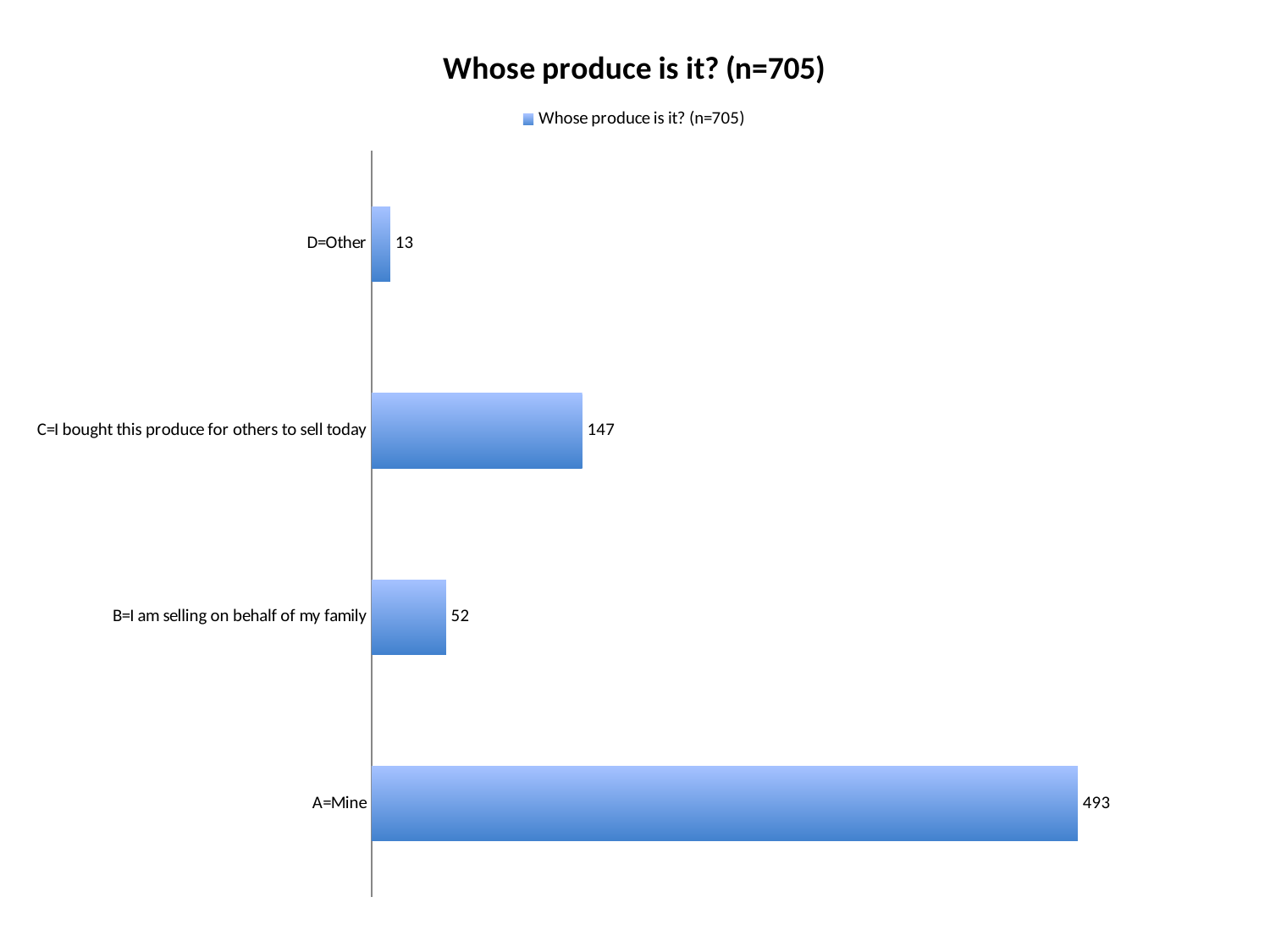
How many categories are shown in the chart? 4 What is the difference between the values for B=I am selling on behalf of my family and D=Other? 39 What is the value for B=I am selling on behalf of my family? 52 What is the title of the chart? Whose produce is it? (n=705) What is the value for A=Mine? 493 Which category has the lowest value? D=Other Which category has the highest value? A=Mine What is the difference between the values for A=Mine and C=I bought this produce for others to sell today? 346 What kind of chart is shown on the slide? Bar chart Which is larger, the value for C=I bought this produce for others to sell today or B=I am selling on behalf of my family? C=I bought this produce for others to sell today What is the value for D=Other? 13 What is the value for C=I bought this produce for others to sell today? 147